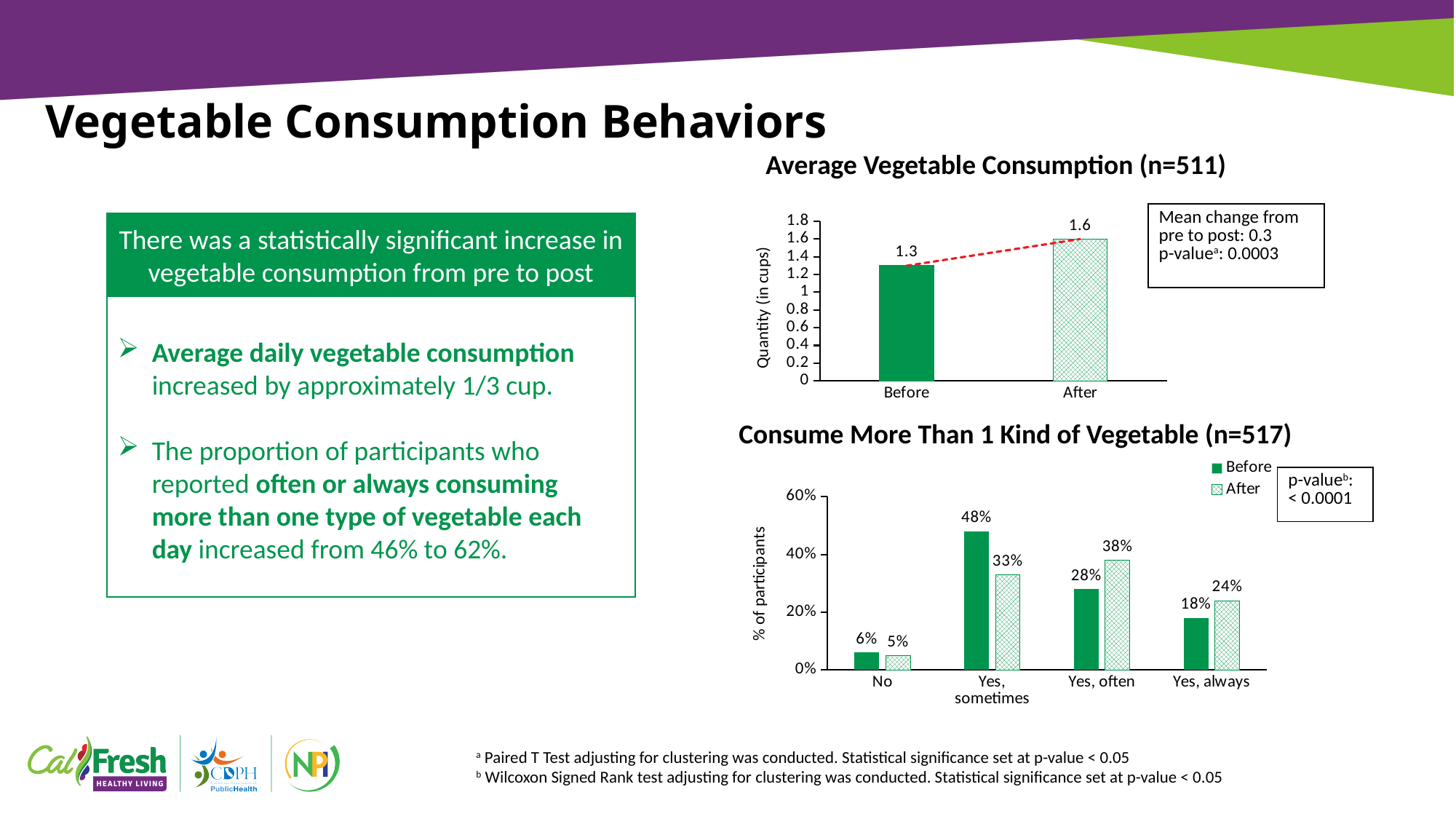
In the 'Average Vegetable Consumption (n=511)' chart, what is the y-axis label? Quantity (in cups) In the 'Consume More Than 1 Kind of Vegetable (n=517)' chart, how many categories are shown on the x-axis? 4 In the 'Average Vegetable Consumption (n=511)' chart, what is the value for Before? 1.3 In the 'Average Vegetable Consumption (n=511)' chart, what is the difference between the After and Before values? 0.3 In the 'Average Vegetable Consumption (n=511)' chart, what is the value for After? 1.6 In the 'Consume More Than 1 Kind of Vegetable (n=517)' chart, what is the After value for 'Yes, often'? 38% In the 'Consume More Than 1 Kind of Vegetable (n=517)' chart, which category has the highest Before value? Yes, sometimes In the 'Consume More Than 1 Kind of Vegetable (n=517)' chart, which category has the lowest After value? No In the 'Consume More Than 1 Kind of Vegetable (n=517)' chart, what is the Before value for 'Yes, sometimes'? 48% In the 'Consume More Than 1 Kind of Vegetable (n=517)' chart, what is the difference between the Before and After values for 'Yes, sometimes'? 15% In the 'Consume More Than 1 Kind of Vegetable (n=517)' chart, how many series does the legend list? 2 In the 'Average Vegetable Consumption (n=511)' chart, what kind of chart is shown? Bar chart